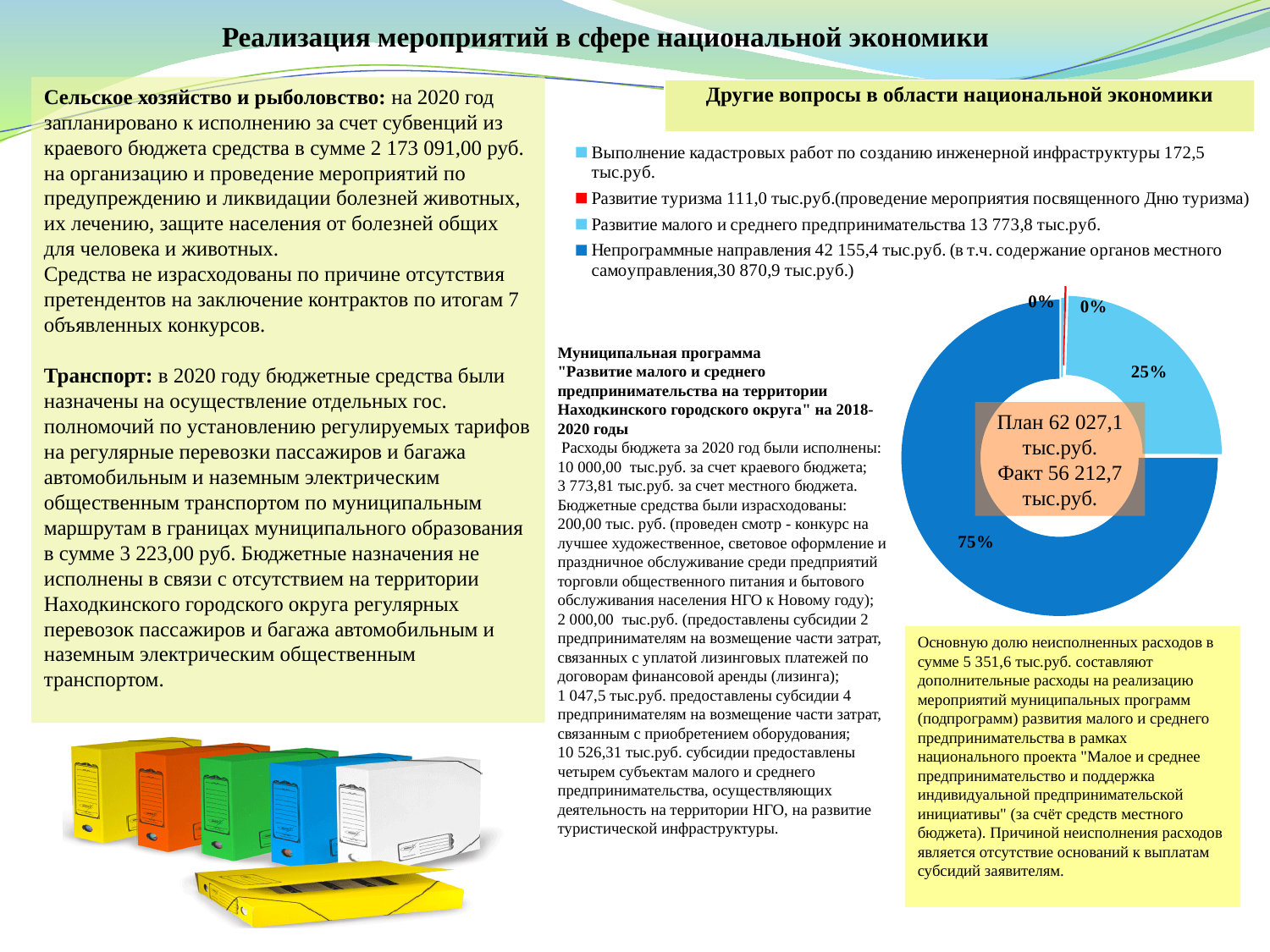
What share is shown for "Развитие туризма" in the pie chart? 0% What share of the pie chart does "Непрограммные направления" take? 75% What plan value (План) is printed in the centre of the pie chart? 62 027,1 тыс.руб. What share of the pie chart does "Развитие малого и среднего предпринимательства" take? 25% What fact value (Факт) is printed in the centre of the pie chart? 56 212,7 тыс.руб. How many categories does the legend of the pie chart list? 4 What is the difference in percentage points between the 75% slice and the 25% slice in the pie chart? 50% What amount is given for "Развитие туризма" in the legend of the pie chart? 111,0 тыс.руб. Which slice is larger in the pie chart: "Непрограммные направления" or "Развитие малого и среднего предпринимательства"? Непрограммные направления What kind of chart is shown under the heading "Другие вопросы в области национальной экономики"? Pie (doughnut) chart Which category has the largest slice in the pie chart? Непрограммные направления How many slices are labelled in the pie chart? 4